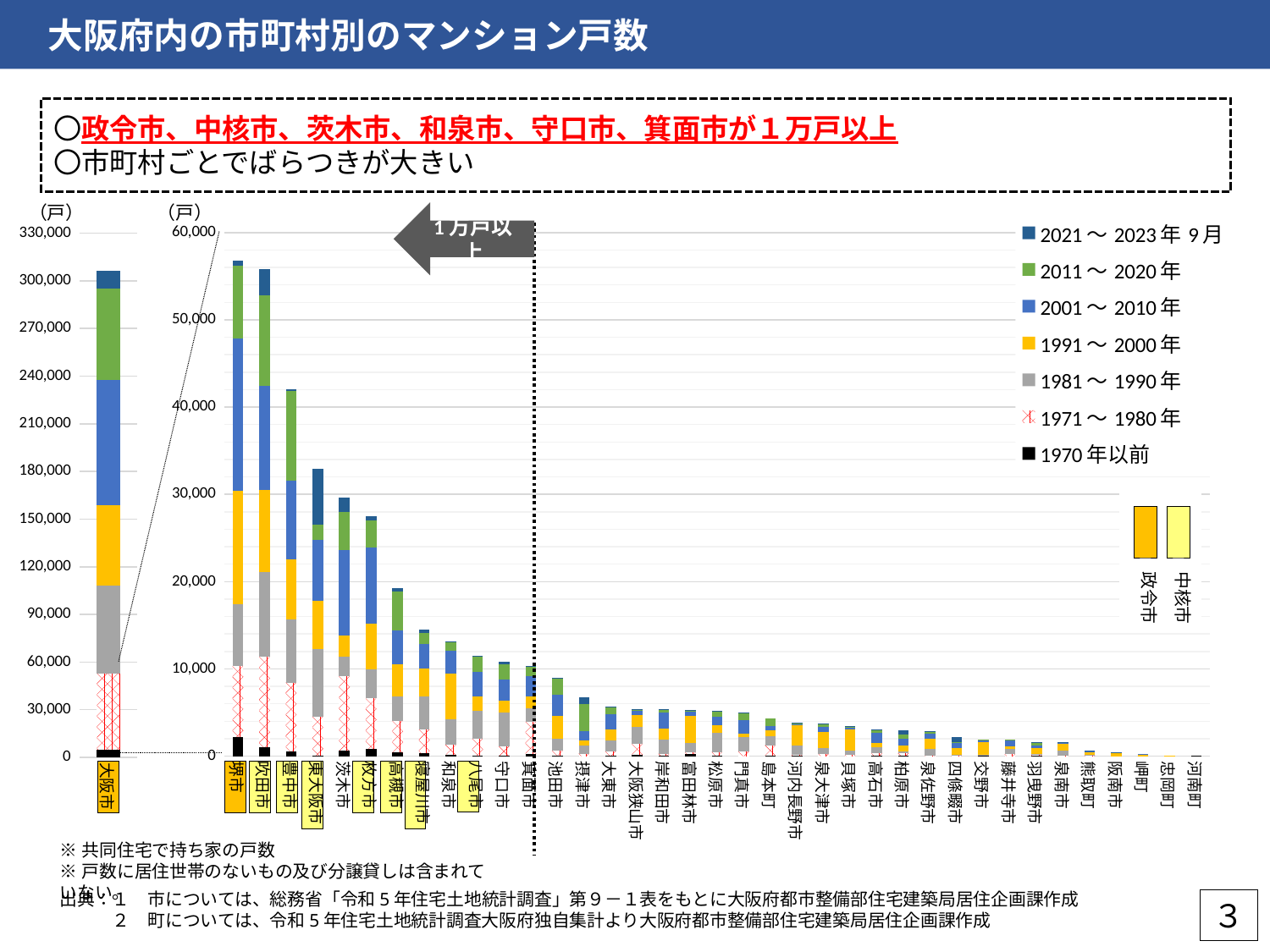
What is the first entry in the legend? 2021～2023年9月 What kind of chart is used on this slide? stacked bar chart In the right chart, which has the larger total, 高槻市 or 寝屋川市? 高槻市 What is the title of the slide's chart? 大阪府内の市町村別のマンション戸数 In the left chart, is the total value for 大阪市 greater or less than 270,000? greater How many series does the legend list? 7 In the right chart, is the total value for 豊中市 greater or less than 40,000? greater In the right chart, is the total value for 東大阪市 greater or less than 30,000? greater In the right chart, do the bar totals rise or fall from left to right along the x axis? fall In the right chart, which has the larger total, 豊中市 or 東大阪市? 豊中市